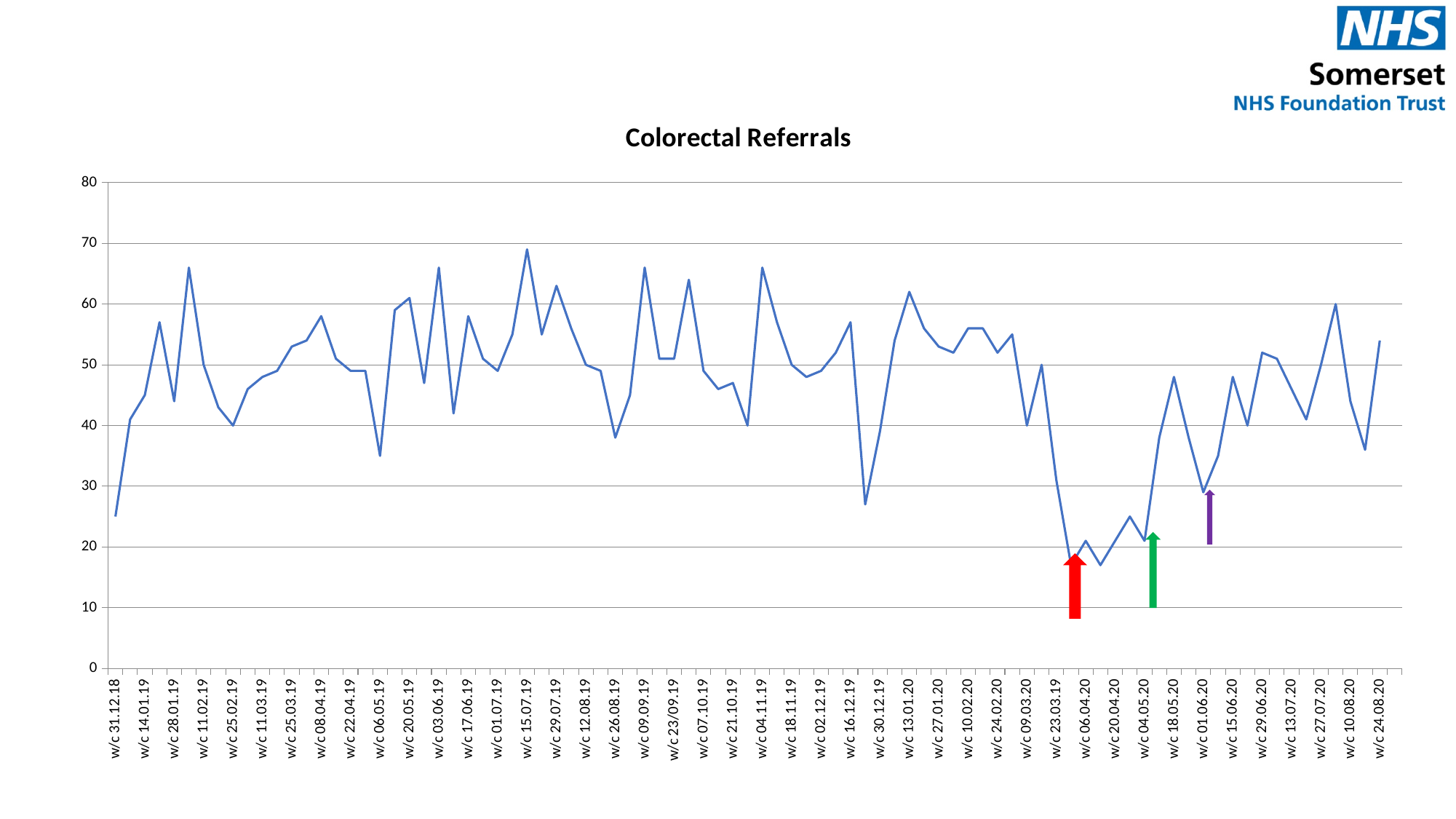
What is the title of the chart? Colorectal Referrals Is the value for w/c 04.11.19 greater or less than 60? greater Which week has the highest number of colorectal referrals? w/c 15.07.19 Which is larger, the value for w/c 15.07.19 or the value for w/c 31.12.18? w/c 15.07.19 Is the value for w/c 06.05.19 greater or less than 40? less Is the value for w/c 31.12.18 greater or less than 30? less What type of chart is shown on the slide? line chart